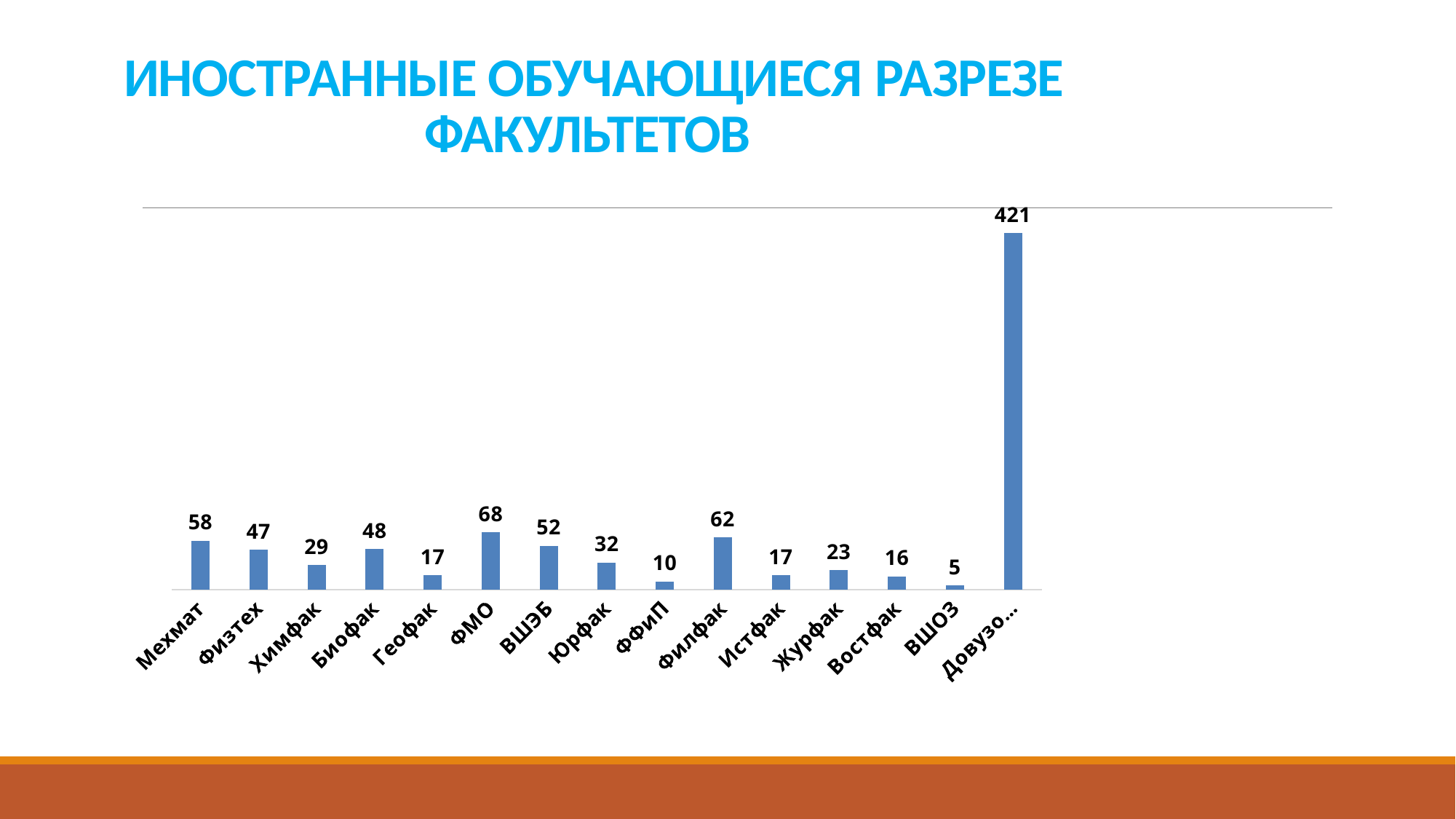
What is the value for Мехмат? 58 What type of chart is shown on the slide? bar chart What is the value for Филфак? 62 What is the highest value shown on the chart? 421 What is the value for ФМО? 68 What is the value for ФФиП? 10 Which has a larger value, Физтех or Биофак? Биофак How many categories are shown on the chart? 15 What is the title of the slide? ИНОСТРАННЫЕ ОБУЧАЮЩИЕСЯ РАЗРЕЗЕ ФАКУЛЬТЕТОВ Which category has the lowest value? ВШОЗ What is the difference between the values for ФМО and Филфак? 6 What is the difference between the values for Мехмат and Химфак? 29